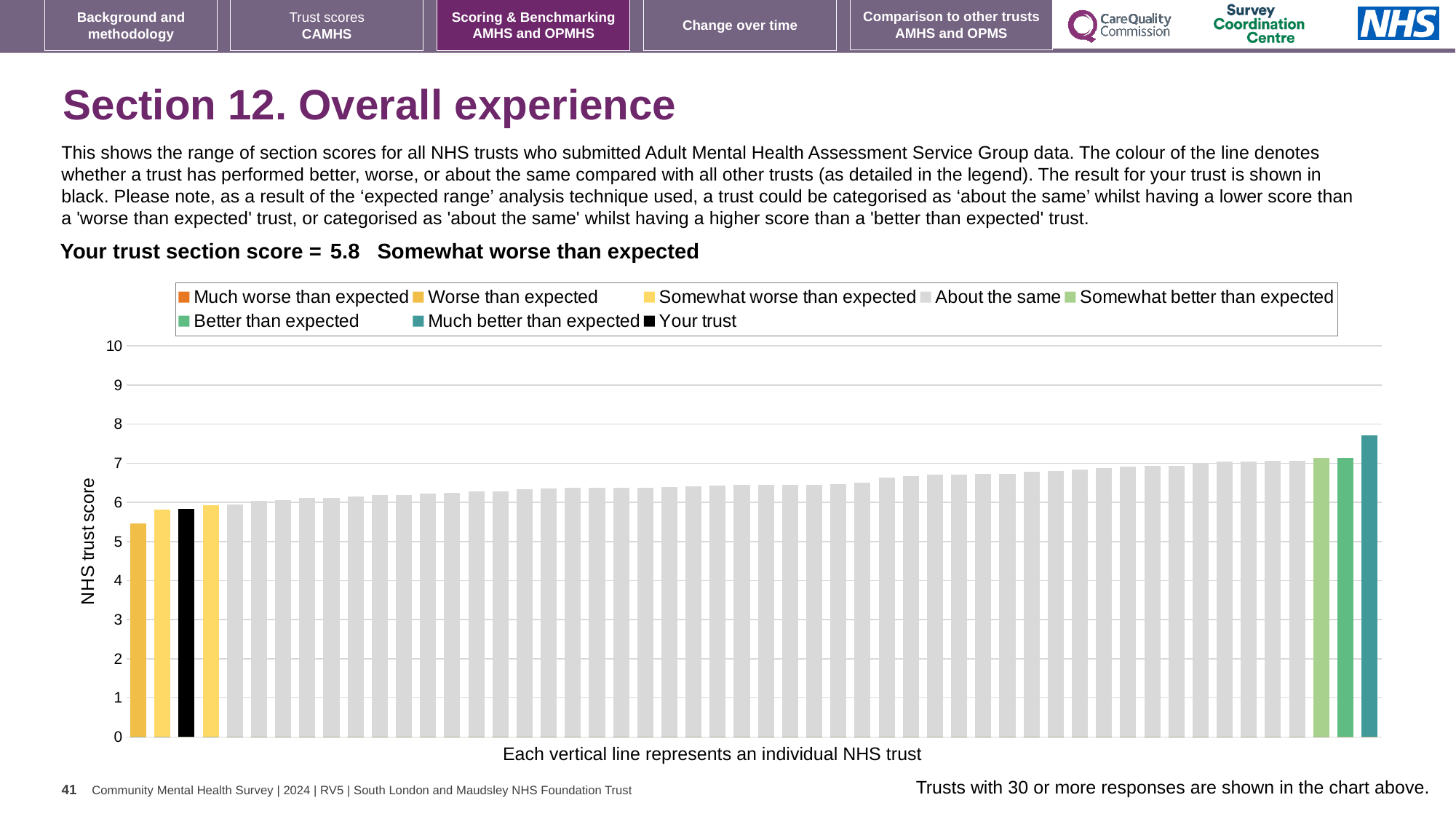
What is the section score for your trust shown on the slide? 5.8 What does each vertical line in the chart represent, according to the label below the chart? an individual NHS trust Is the value of the tallest bar (the teal bar at the far right) greater or less than 7? greater Do the bar values rise or fall moving from left to right along the x axis? rise What kind of chart is shown on the slide? bar chart Which legend category does your trust's section score fall into? Somewhat worse than expected Which legend category does the tallest bar belong to? Much better than expected What is the label on the vertical axis of the chart? NHS trust score How many entries does the chart legend list? 8 Is the leftmost bar taller or shorter than the black 'Your trust' bar? shorter Is the value of the leftmost bar greater or less than 5? greater Is the value of the black 'Your trust' bar greater or less than 6? less